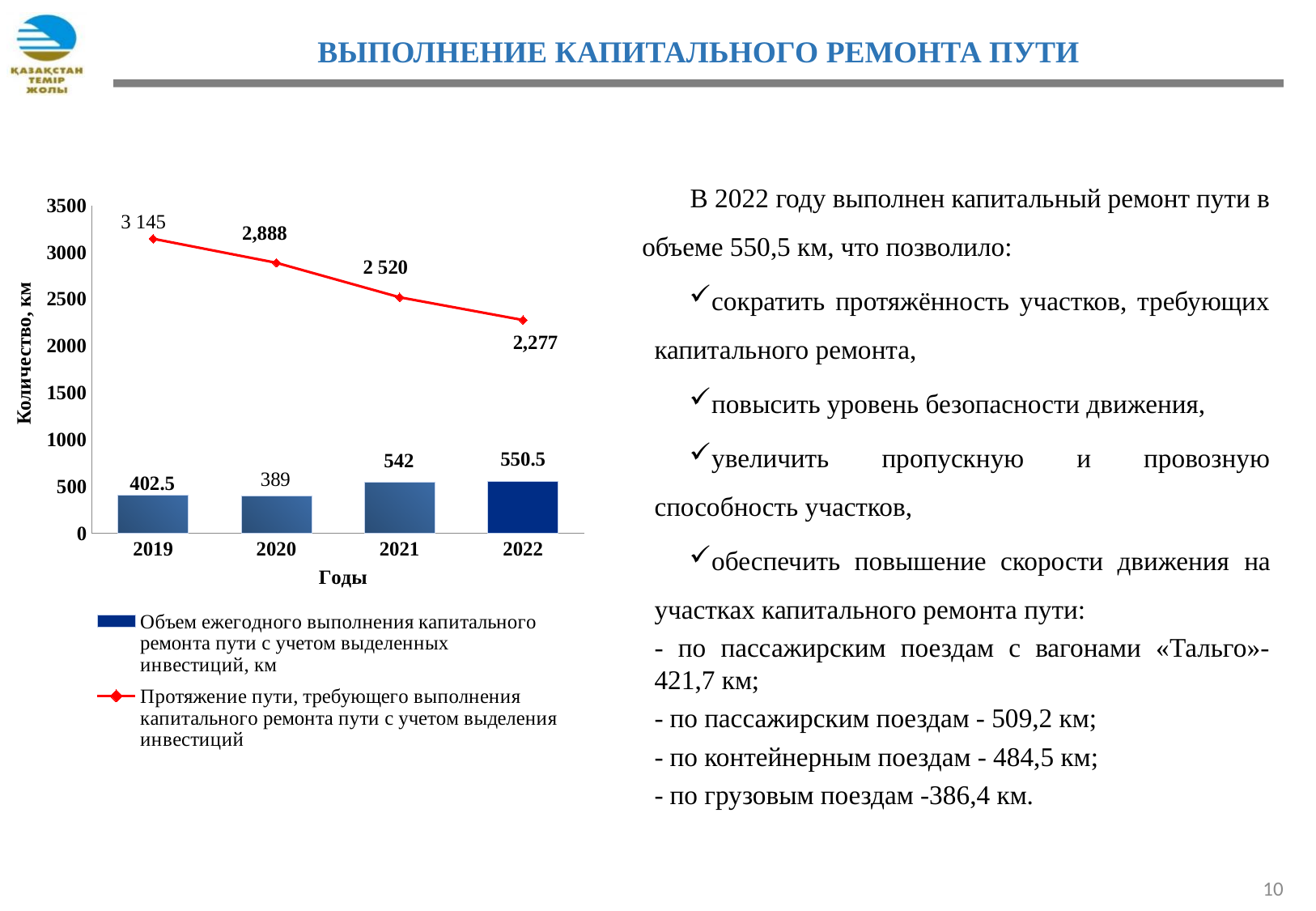
How many series does the legend list? 2 Which is larger: the bar value for 2019 or for 2020? 2019 Which year has the lowest bar value? 2020 What is the difference between the red line values for 2019 and 2022? 868 What is the value of the bar for 2022 (Объем ежегодного выполнения капитального ремонта пути)? 550.5 What value does the red line show for 2022? 2,277 What is the value of the bar for 2020? 389 What is the difference between the bar values for 2022 and 2021? 8.5 Which year has the highest bar value? 2022 How many years are shown on the x axis? 4 What value does the red line (Протяжение пути, требующего выполнения капитального ремонта) show for 2019? 3 145 Does the red line rise or fall from 2019 to 2022? Falls